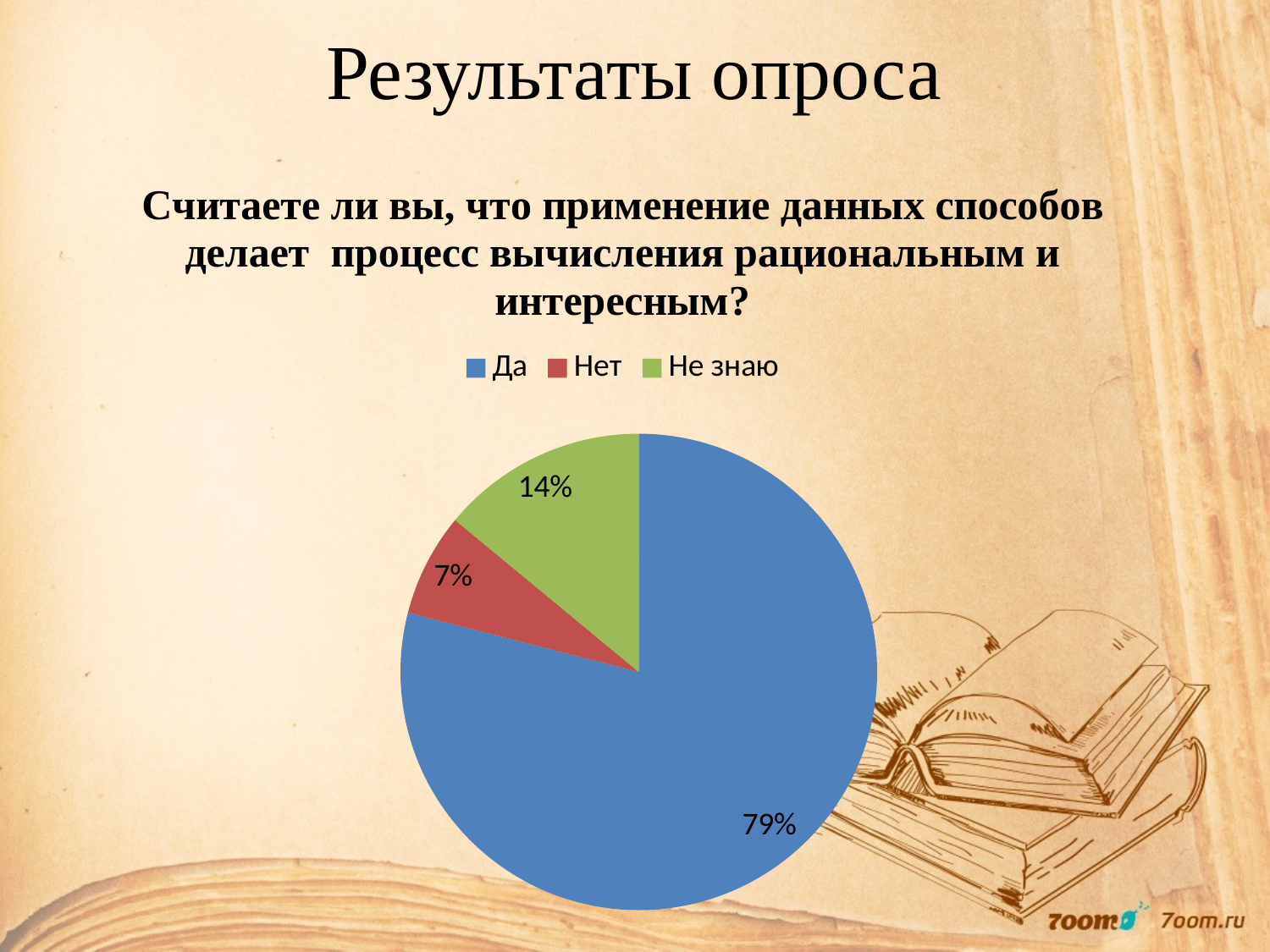
Which answer has the smallest share of the pie? Нет How many entries does the legend list? 3 What percentage of respondents answered "Да"? 79% What percentage of respondents answered "Нет"? 7% What kind of chart is shown on the slide? pie chart What is the difference in percentage points between "Не знаю" and "Нет"? 7 Which is larger, the share for "Нет" or the share for "Не знаю"? Не знаю What colour is the slice for "Не знаю"? green Which answer has the largest share of the pie? Да What is the difference in percentage points between "Да" and "Не знаю"? 65 What percentage of respondents answered "Не знаю"? 14% How many slices does the pie chart have? 3